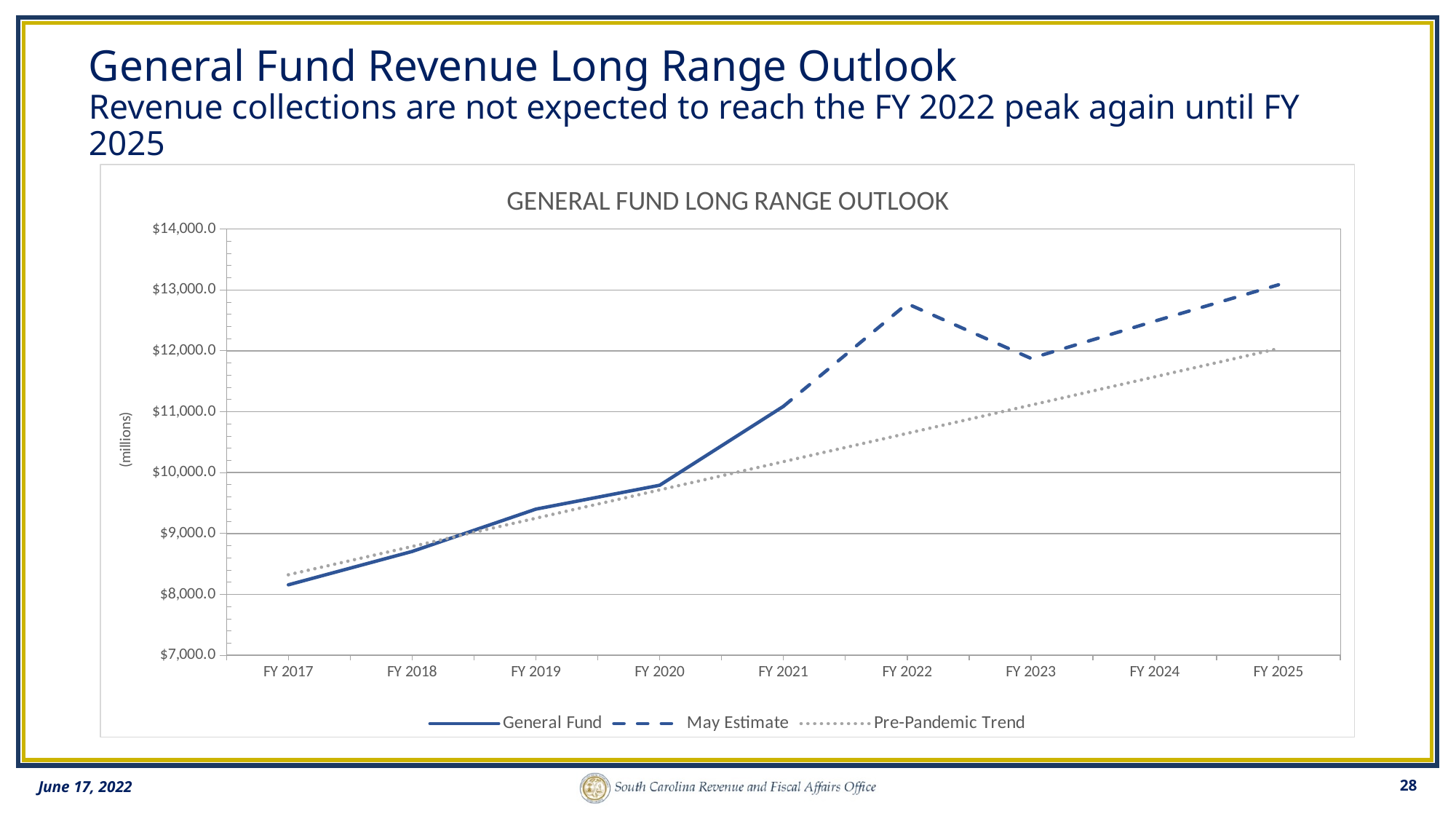
Is the May Estimate value for FY 2022 greater or less than $12,000.0? greater Which is larger, the May Estimate for FY 2022 or the May Estimate for FY 2023? FY 2022 How many series does the legend list? 3 Is the General Fund value for FY 2021 greater or less than $11,000.0? greater How many fiscal years are shown on the x axis? 9 Does the General Fund series rise or fall from FY 2017 to FY 2021? Rise In which fiscal year is the General Fund series at its lowest value? FY 2017 Is the General Fund value for FY 2017 greater or less than $9,000.0? less What is the title of the chart? GENERAL FUND LONG RANGE OUTLOOK In which fiscal year does the May Estimate series reach its highest value? FY 2025 What type of chart is shown on the slide? Line chart